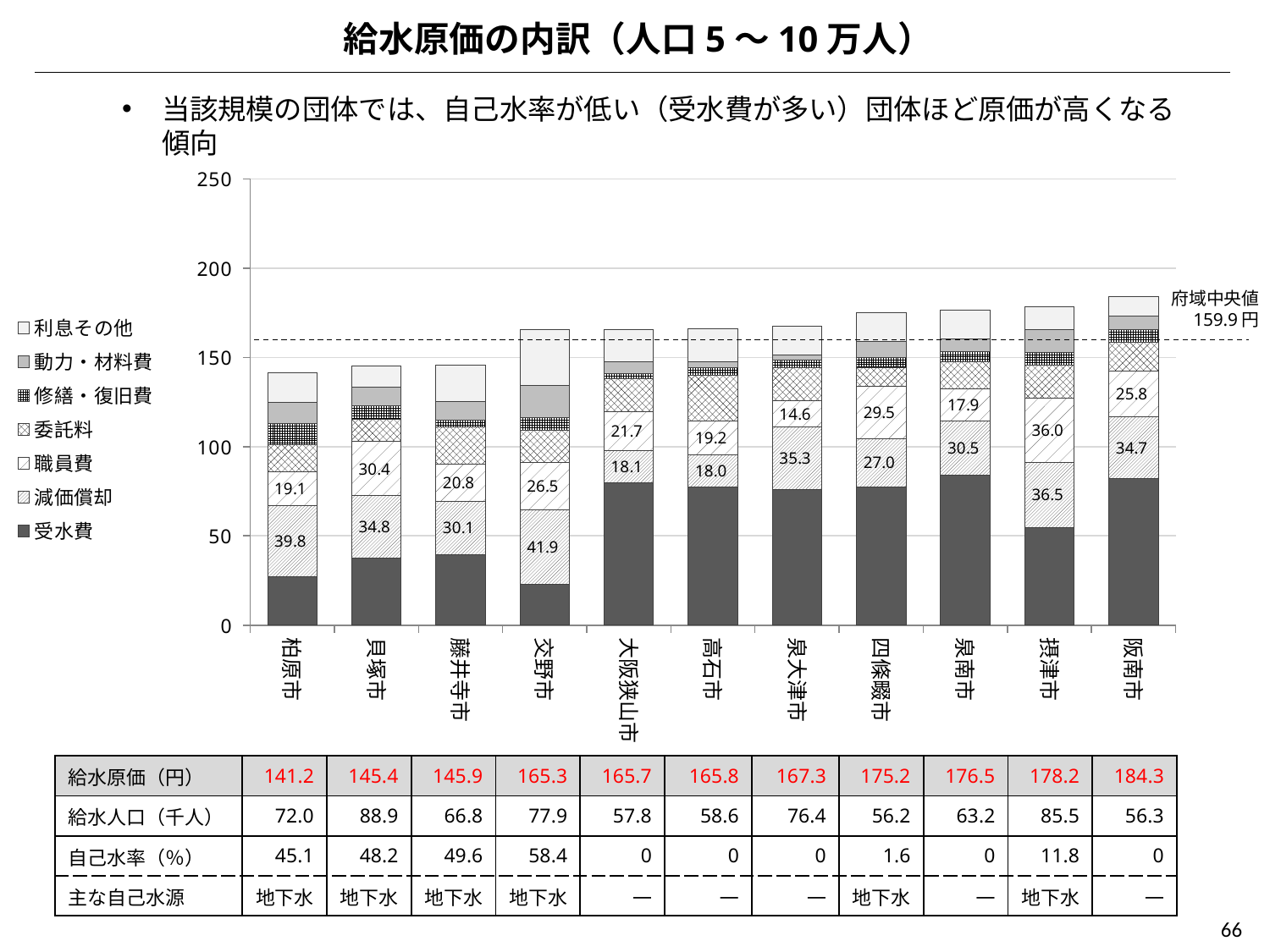
What is the 減価償却 value labelled for 交野市? 41.9 What is the difference in 給水原価 between 阪南市 and 柏原市? 43.1 How many municipalities are plotted along the x axis of the chart? 11 Is the total bar for 柏原市 greater or less than 150? less Do the total bar heights rise or fall from left to right across the x axis? rise Which municipality has the lowest 給水原価? 柏原市 How many series does the chart's legend list? 7 Which municipality has the highest 給水原価? 阪南市 What is the 給水原価 (total bar height) for 阪南市? 184.3 What kind of chart is shown on the slide? stacked bar chart What value does the dashed 府域中央値 line mark? 159.9円 Which has the larger 給水原価, 交野市 or 泉南市? 泉南市